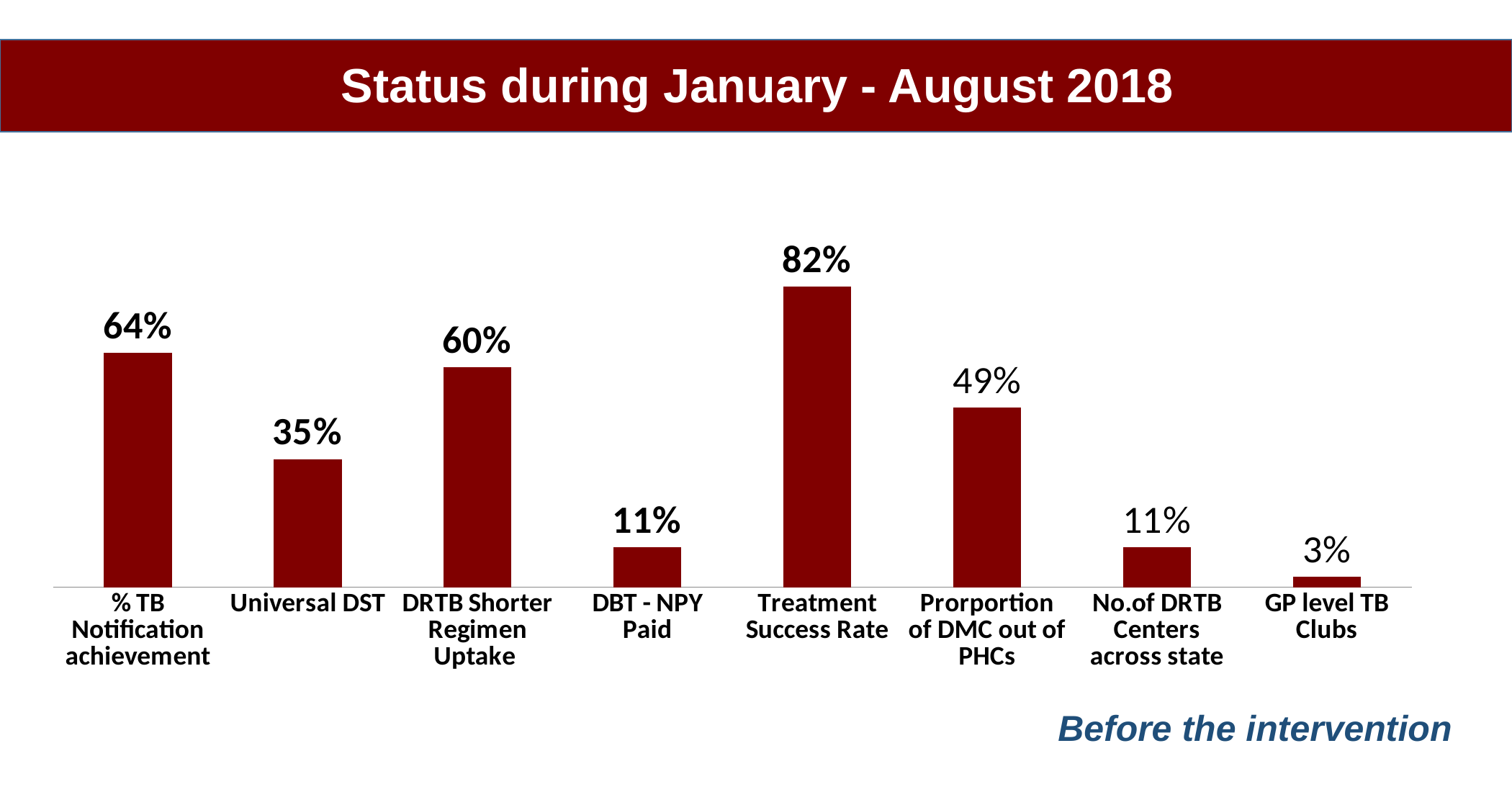
What is the value for Treatment Success Rate? 82% What is the value for Universal DST? 35% What is the title shown at the top of the slide? Status during January - August 2018 What is the difference between Treatment Success Rate and DRTB Shorter Regimen Uptake? 22% How many categories are shown in the chart? 8 What is the value for Prorportion of DMC out of PHCs? 49% Which is larger, % TB Notification achievement or DRTB Shorter Regimen Uptake? % TB Notification achievement What is the value for GP level TB Clubs? 3% Which category has the lowest value? GP level TB Clubs What kind of chart is shown on the slide? Bar chart What is the difference between % TB Notification achievement and Universal DST? 29% Which category has the highest value? Treatment Success Rate